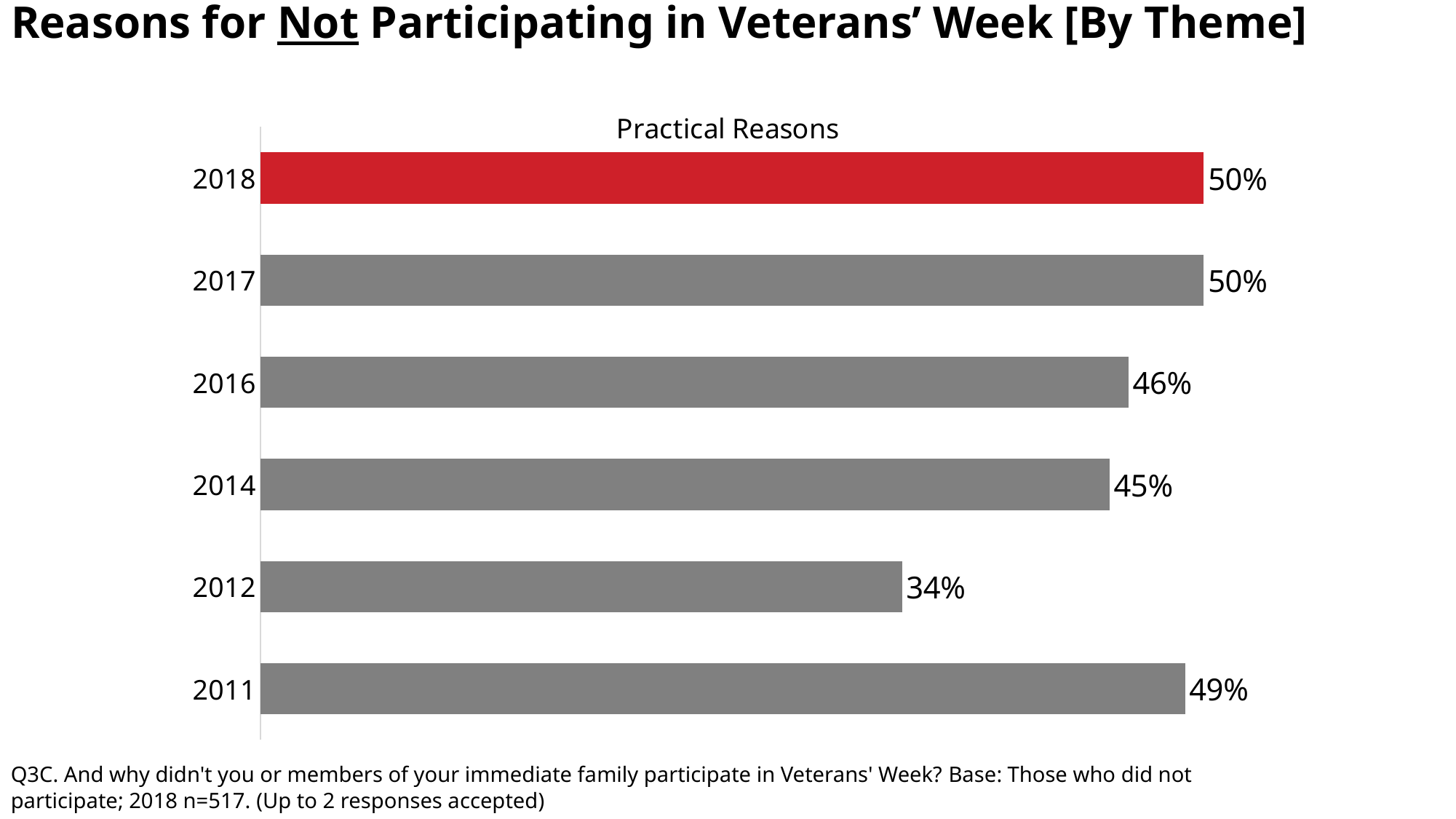
What is the value for 2018 in the Practical Reasons chart? 50% What is the value for 2012 in the Practical Reasons chart? 34% What kind of chart is shown on the slide? Bar chart Which year has the lowest value in the Practical Reasons chart? 2012 What is the difference between the values for 2018 and 2012? 16% What is the value for 2011 in the Practical Reasons chart? 49% How many years are shown in the chart? 6 Which year's bar is coloured red? 2018 Which is larger, the value for 2011 or the value for 2012? 2011 What is the difference between the values for 2016 and 2014? 1% What is the title of the chart? Practical Reasons What is the value for 2014 in the Practical Reasons chart? 45%